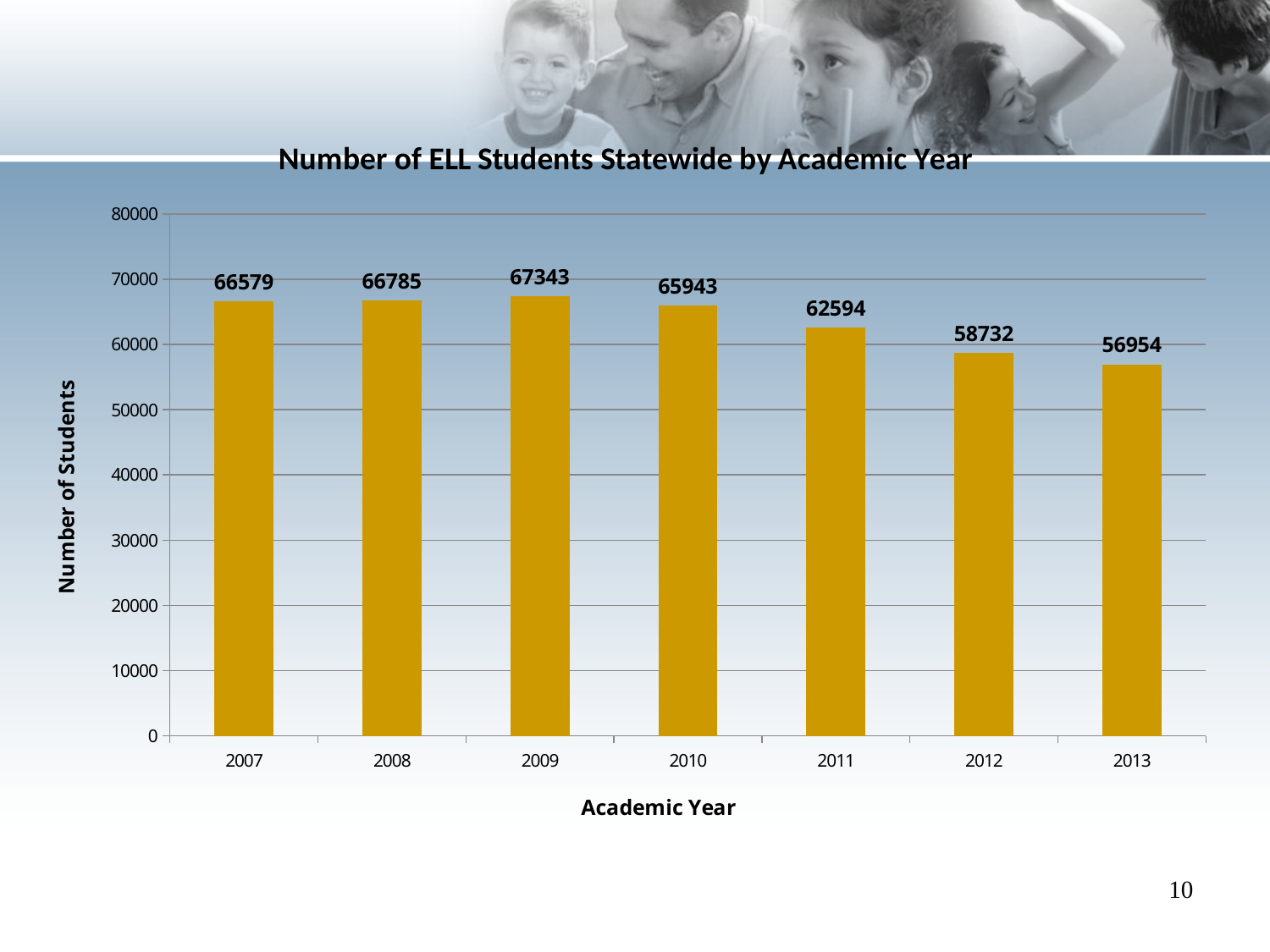
What is the difference in the number of ELL students between 2011 and 2012? 3862 Which academic year has the lowest number of ELL students? 2013 Which year has more ELL students, 2010 or 2012? 2010 What is the number of ELL students statewide in 2013? 56954 What kind of chart is shown on the slide? bar chart Which academic year has the highest number of ELL students? 2009 Is the number of ELL students in 2012 greater or less than 60000? less What is the difference in the number of ELL students between 2009 and 2013? 10389 What is the number of ELL students statewide in 2011? 62594 What is the label of the vertical axis? Number of Students How many academic years are shown in the chart? 7 What is the number of ELL students statewide in 2009? 67343